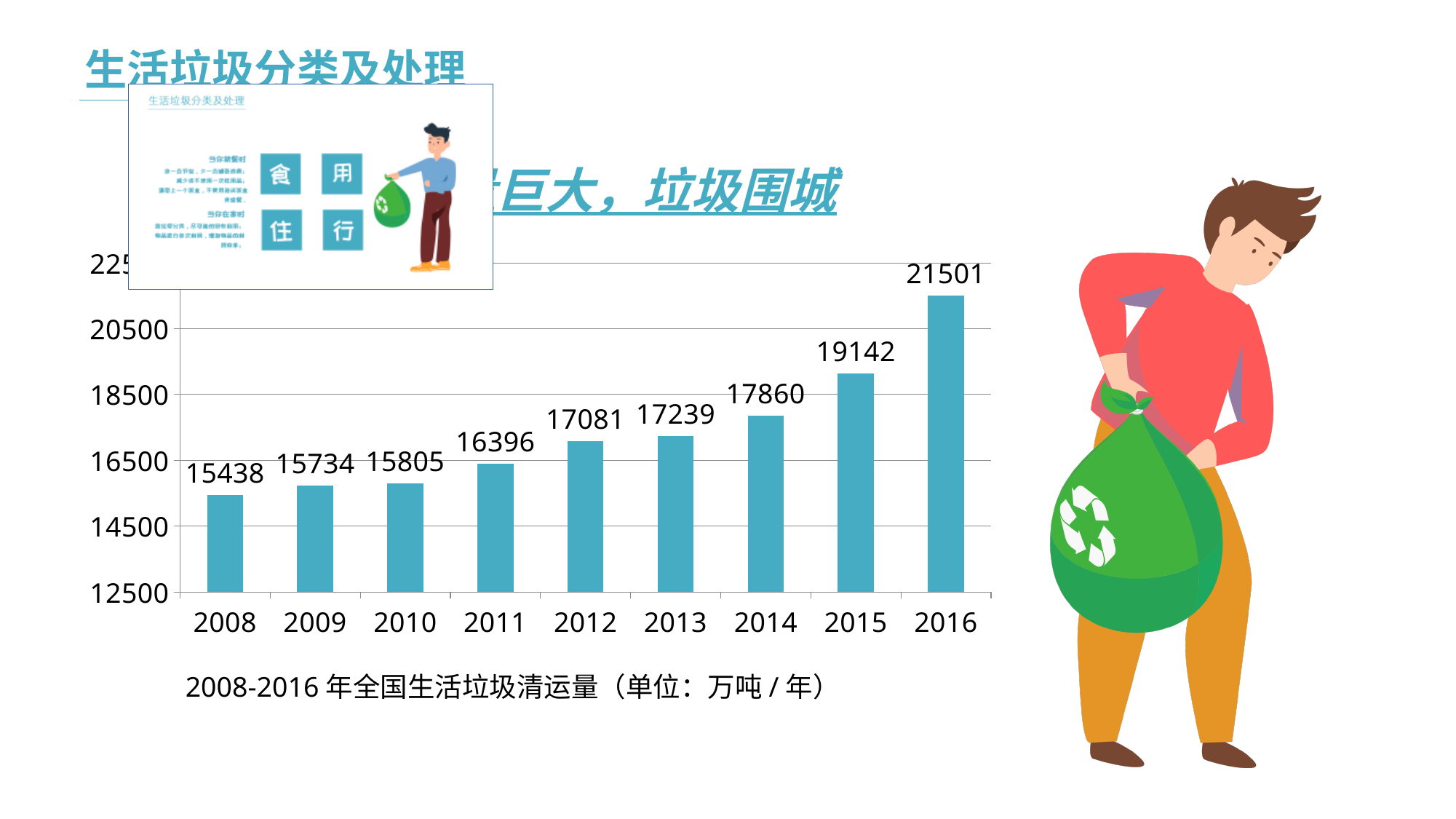
Do the values rise or fall from 2008 to 2016? rise What kind of chart is shown on the slide? bar chart What is the value for 2015? 19142 What is the value for 2008? 15438 Which year has the lowest value? 2008 Which is larger, the value for 2014 or the value for 2013? 2014 Which year has the highest value? 2016 What is the difference between the values for 2011 and 2010? 591 What is the difference between the values for 2016 and 2015? 2359 Is the value for 2015 greater or less than 18500? greater How many years are shown on the x axis? 9 What is the value for 2012? 17081